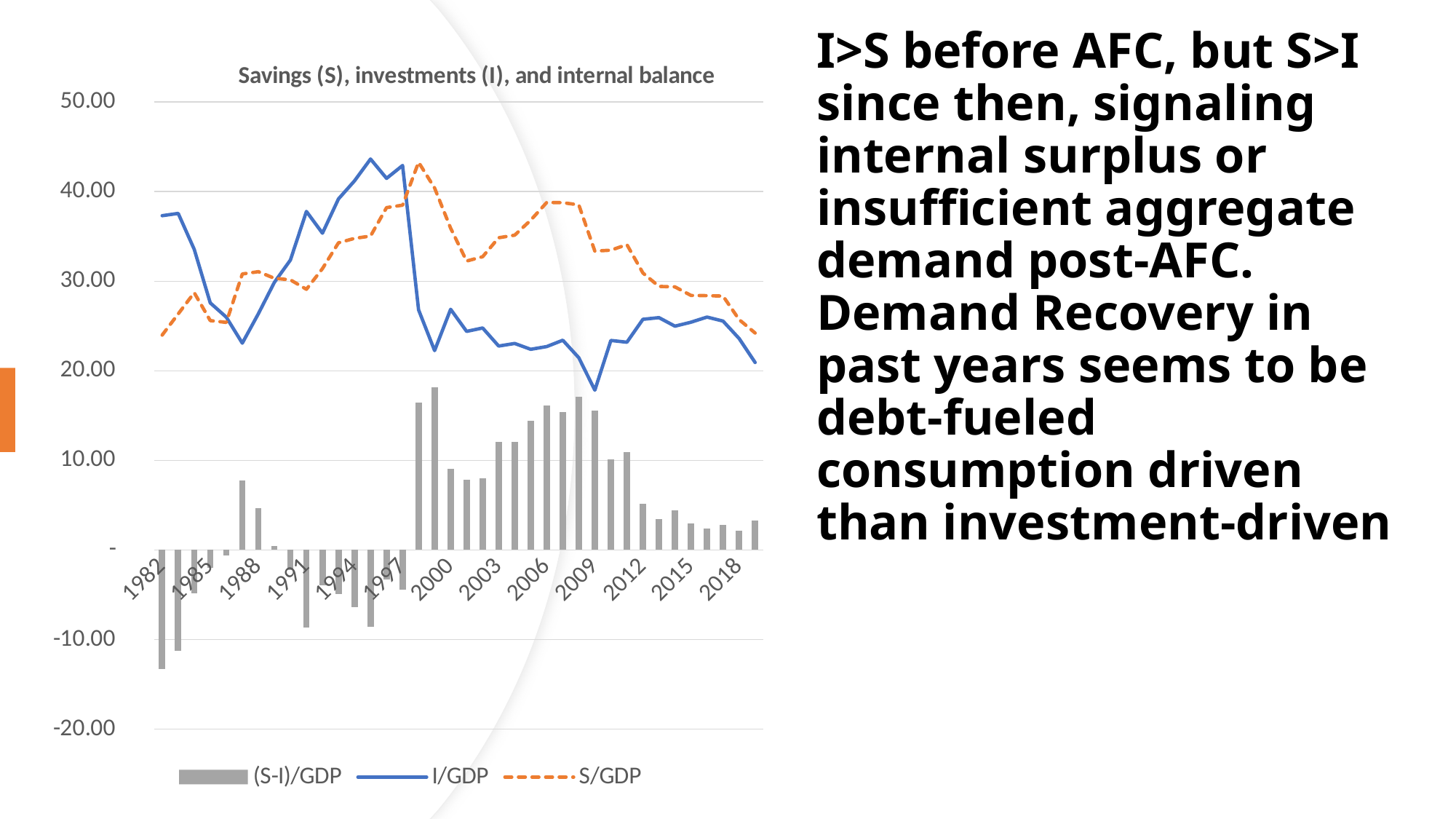
Is the value of S/GDP in 1982 greater or less than 30? less In 2015, which is larger, S/GDP or I/GDP? S/GDP How many series does the legend list? 3 Is the value of (S-I)/GDP in 2000 greater or less than 10? less Is the value of I/GDP in 1982 greater or less than 30? greater Which series is drawn as a dashed line? S/GDP In 1982, which is larger, I/GDP or S/GDP? I/GDP How many year labels are shown on the x axis? 13 What is the title of the chart? Savings (S), investments (I), and internal balance What kind of chart is this? Combined bar and line chart